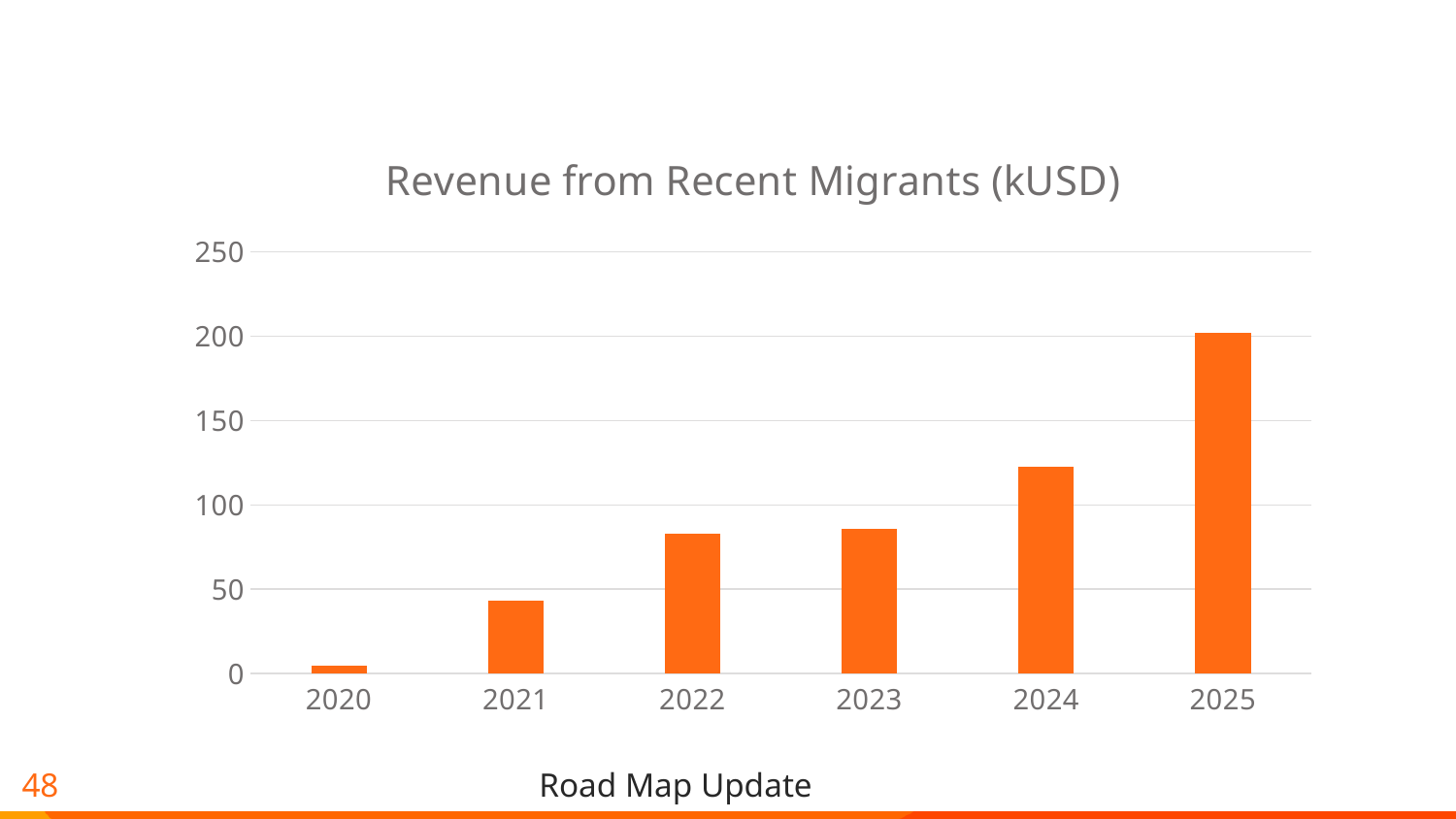
Which year has the lowest revenue from recent migrants? 2020 Is the value for 2024 greater or less than 100? greater What type of chart is shown on the slide? bar chart Which year has the larger revenue, 2025 or 2023? 2025 What is the title of the chart? Revenue from Recent Migrants (kUSD) Which year has the highest revenue from recent migrants? 2025 How many years are shown on the x axis of the chart? 6 Which year has the larger revenue, 2021 or 2024? 2024 Do the revenue values rise or fall from 2020 to 2025? rise Is the value for 2021 greater or less than 50? less Is the value for 2022 greater or less than 100? less